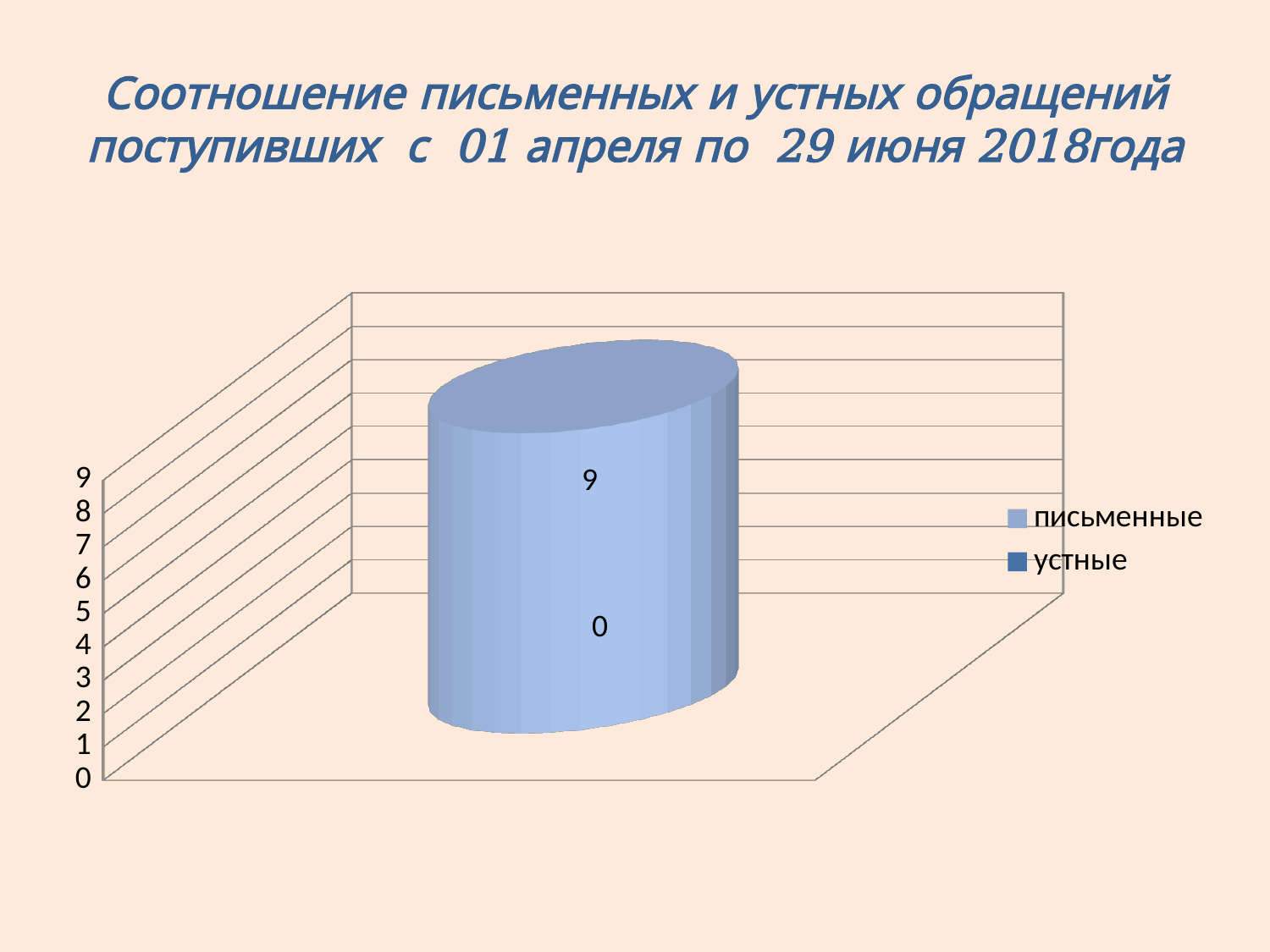
What is the difference between the values for письменные and устные? 9 Which series has the highest value? письменные Is the value for письменные greater or less than 5? greater What is the value for устные? 0 How many series does the legend list? 2 What are the two legend entries of the chart? письменные, устные What is the maximum value shown on the vertical axis? 9 Which series has the lowest value? устные What is the value for письменные? 9 Which series has the higher value, письменные or устные? письменные What kind of chart is shown on the slide? bar chart